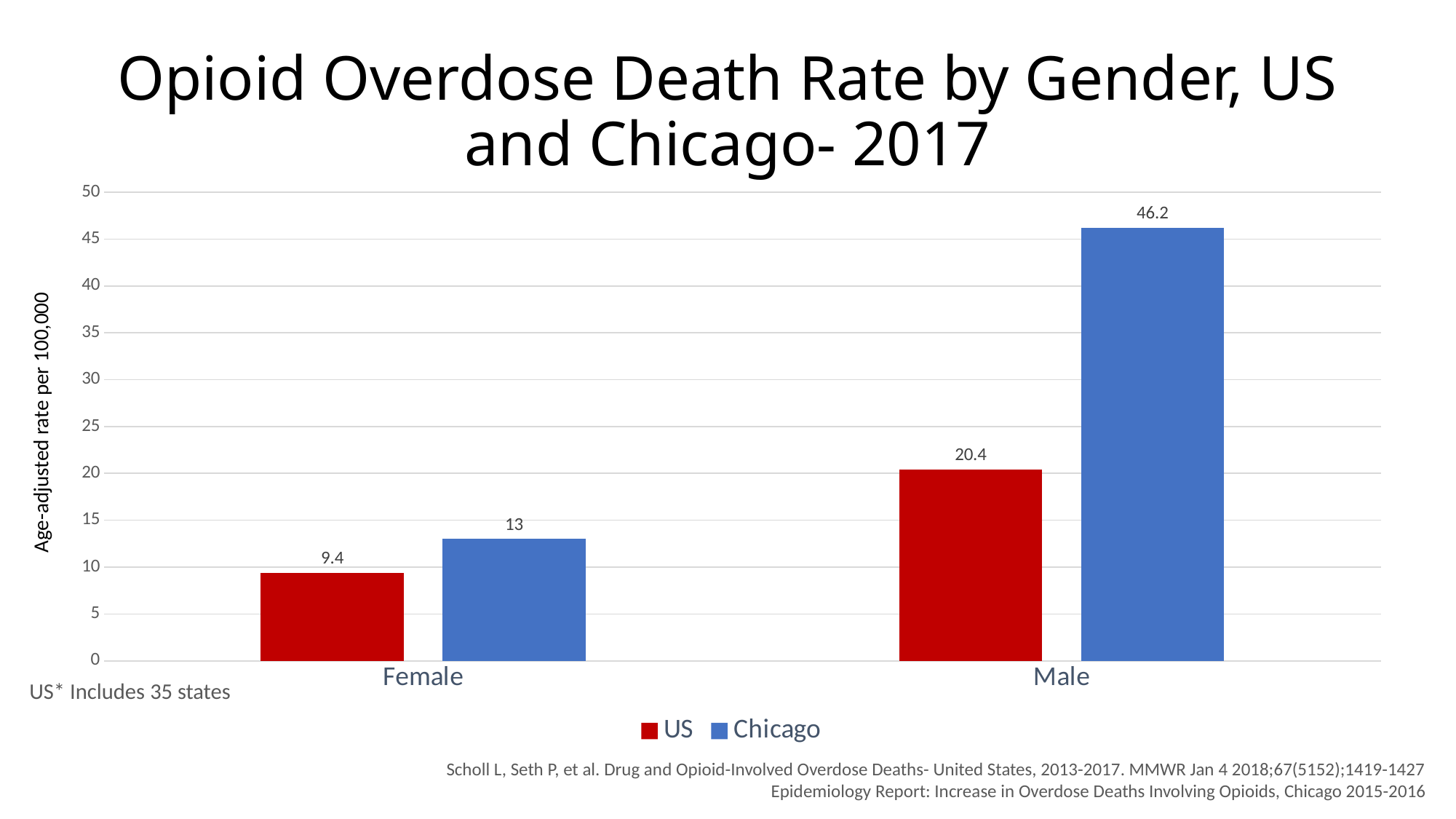
What is the Chicago value for Female? 13 What is the US opioid overdose death rate for females? 9.4 What kind of chart is shown on the slide? Bar chart What is the Chicago opioid overdose death rate for males? 46.2 Which is larger, the US rate for males or the Chicago rate for females? US rate for males What is the US value for Male? 20.4 Which bar has the lowest value on the chart? US, Female What is the difference between the Chicago and US rates for males? 25.8 Which bar has the highest value on the chart? Chicago, Male What is the y-axis label of the chart? Age-adjusted rate per 100,000 What is the difference between the Chicago and US rates for females? 3.6 How many series does the legend list? 2